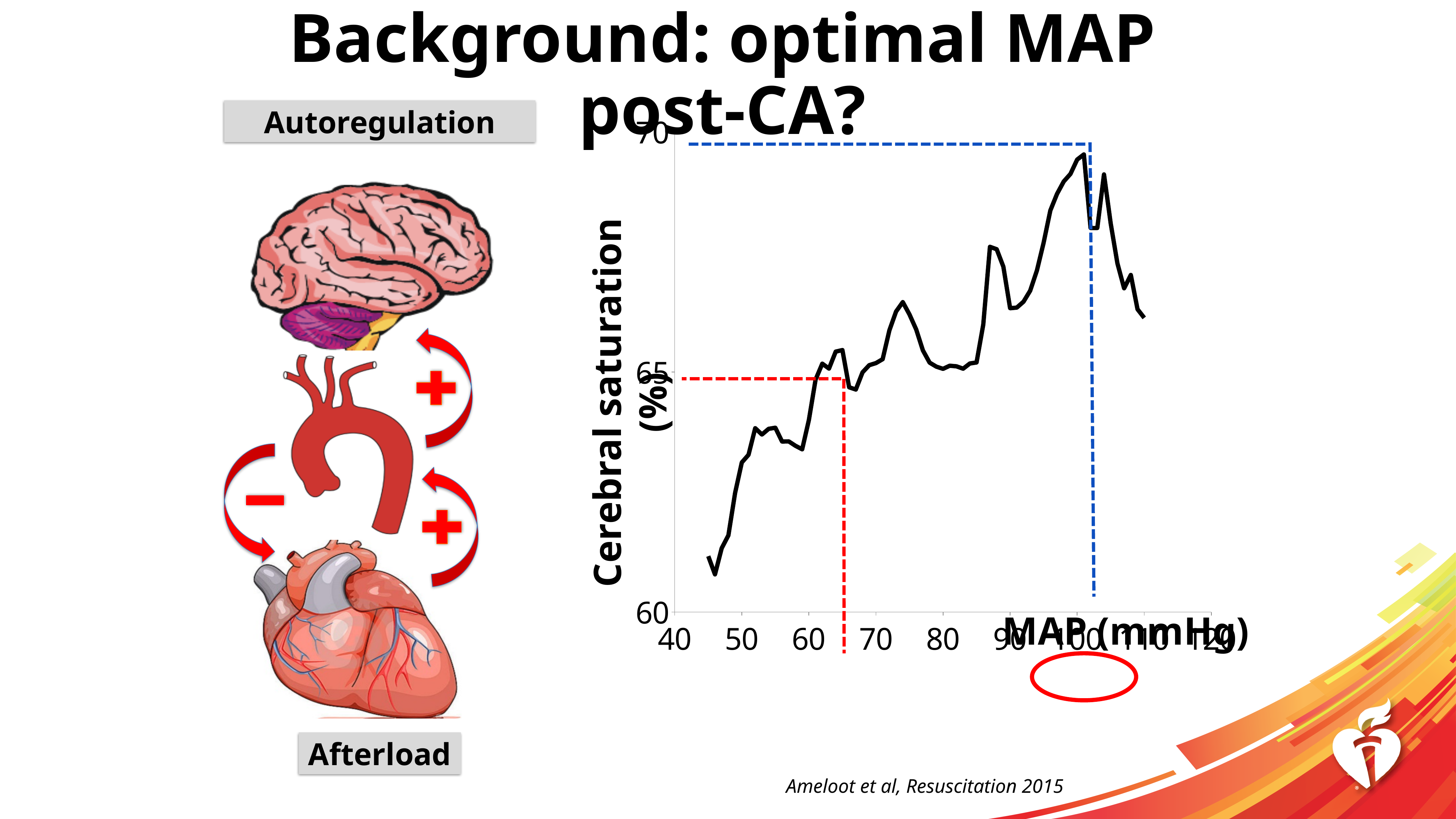
Is the highest cerebral saturation value on the line greater or less than 70%? less Does cerebral saturation generally rise or fall as MAP increases from 40 to 100 mmHg? rise What is the label of the x axis of the chart? MAP (mmHg) What kind of chart is shown on the right of the slide? line chart Is the cerebral saturation higher at a MAP of 100 mmHg or at a MAP of 50 mmHg? 100 mmHg Is the cerebral saturation at a MAP of 60 mmHg greater or less than 65%? less Is the cerebral saturation at a MAP of 50 mmHg greater or less than 65%? less Is the cerebral saturation higher at a MAP of 45 mmHg or at a MAP of 90 mmHg? 90 mmHg Does cerebral saturation rise or fall as MAP increases from 100 to 120 mmHg? fall What is the label of the y axis of the chart? Cerebral saturation (%)